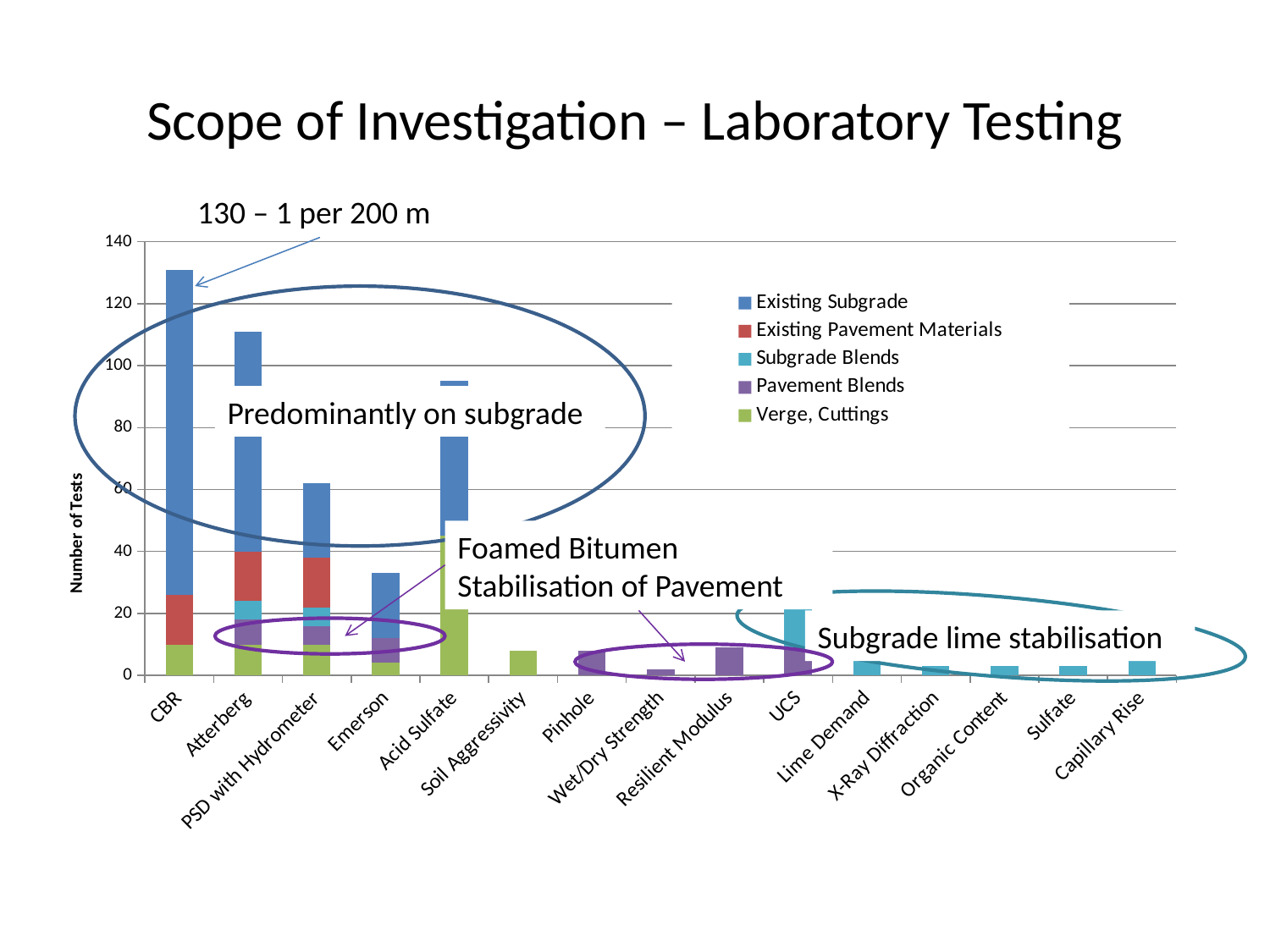
How many series does the chart legend list? 5 What is the title of the vertical axis of the chart? Number of Tests Which test category has the highest total number of tests? CBR Is the total value for Soil Aggressivity greater or less than 20? less Which series is listed first in the chart legend? Existing Subgrade Which has a larger total number of tests, Acid Sulfate or Emerson? Acid Sulfate Is the total value for Emerson greater or less than 40? less How many test categories are shown along the x axis of the chart? 15 Is the total value for CBR greater or less than 120? greater What kind of chart is shown on the slide? bar chart